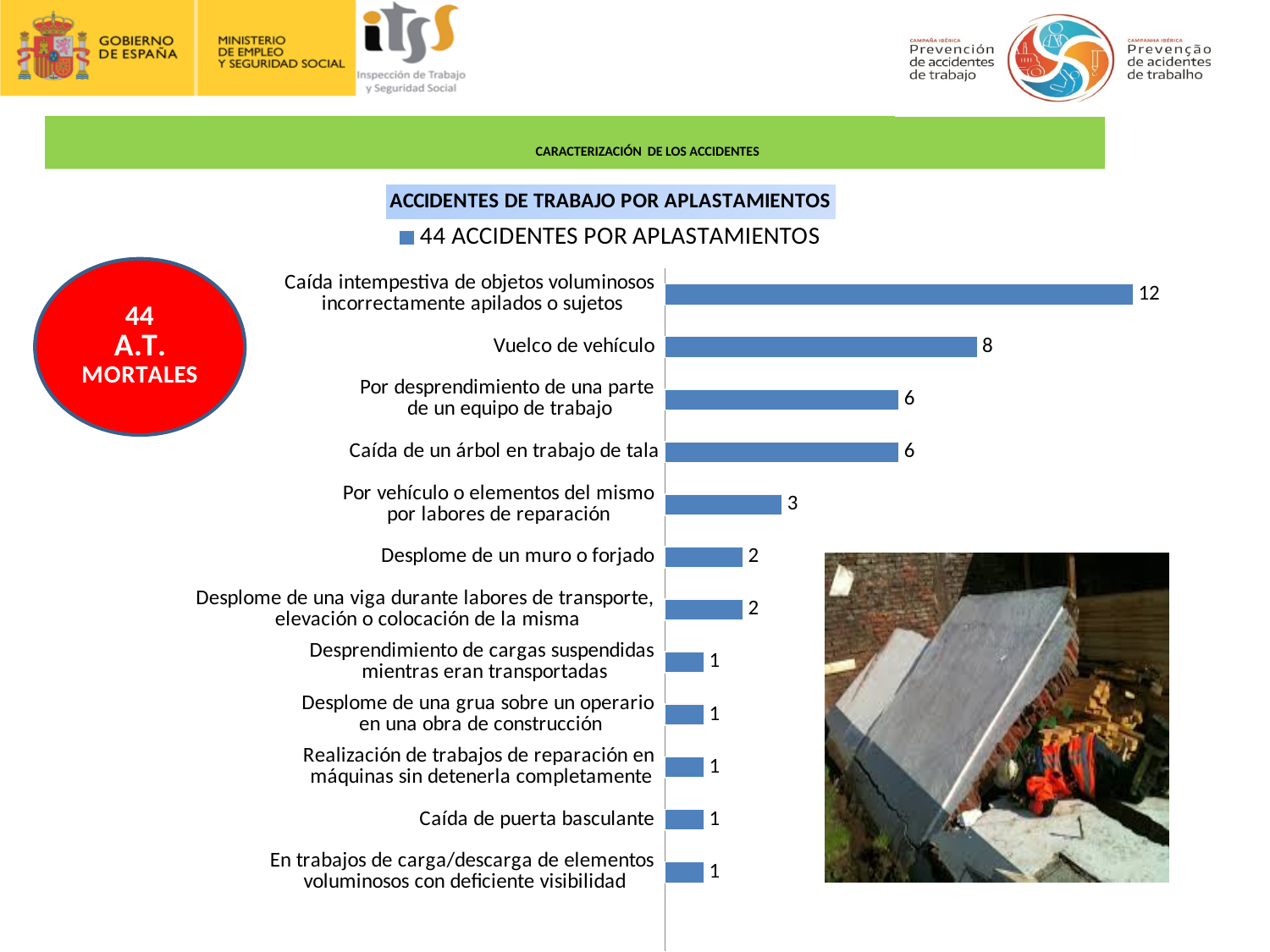
What is the value for "Caída de puerta basculante"? 1 What is the difference between the values for "Por desprendimiento de una parte de un equipo de trabajo" and "Desplome de una viga durante labores de transporte, elevación o colocación de la misma"? 4 What is the value for "Desplome de un muro o forjado"? 2 What is the difference between the values for "Caída intempestiva de objetos voluminosos incorrectamente apilados o sujetos" and "Vuelco de vehículo"? 4 What is the legend entry of the chart? 44 ACCIDENTES POR APLASTAMIENTOS How many series does the legend list? 1 How many categories are shown in the chart? 12 What is the value for "Caída de un árbol en trabajo de tala"? 6 Which category has the highest value? Caída intempestiva de objetos voluminosos incorrectamente apilados o sujetos Which is larger, the value for "Vuelco de vehículo" or the value for "Por vehículo o elementos del mismo por labores de reparación"? Vuelco de vehículo What type of chart is shown on the slide? bar chart What is the value for "Vuelco de vehículo"? 8